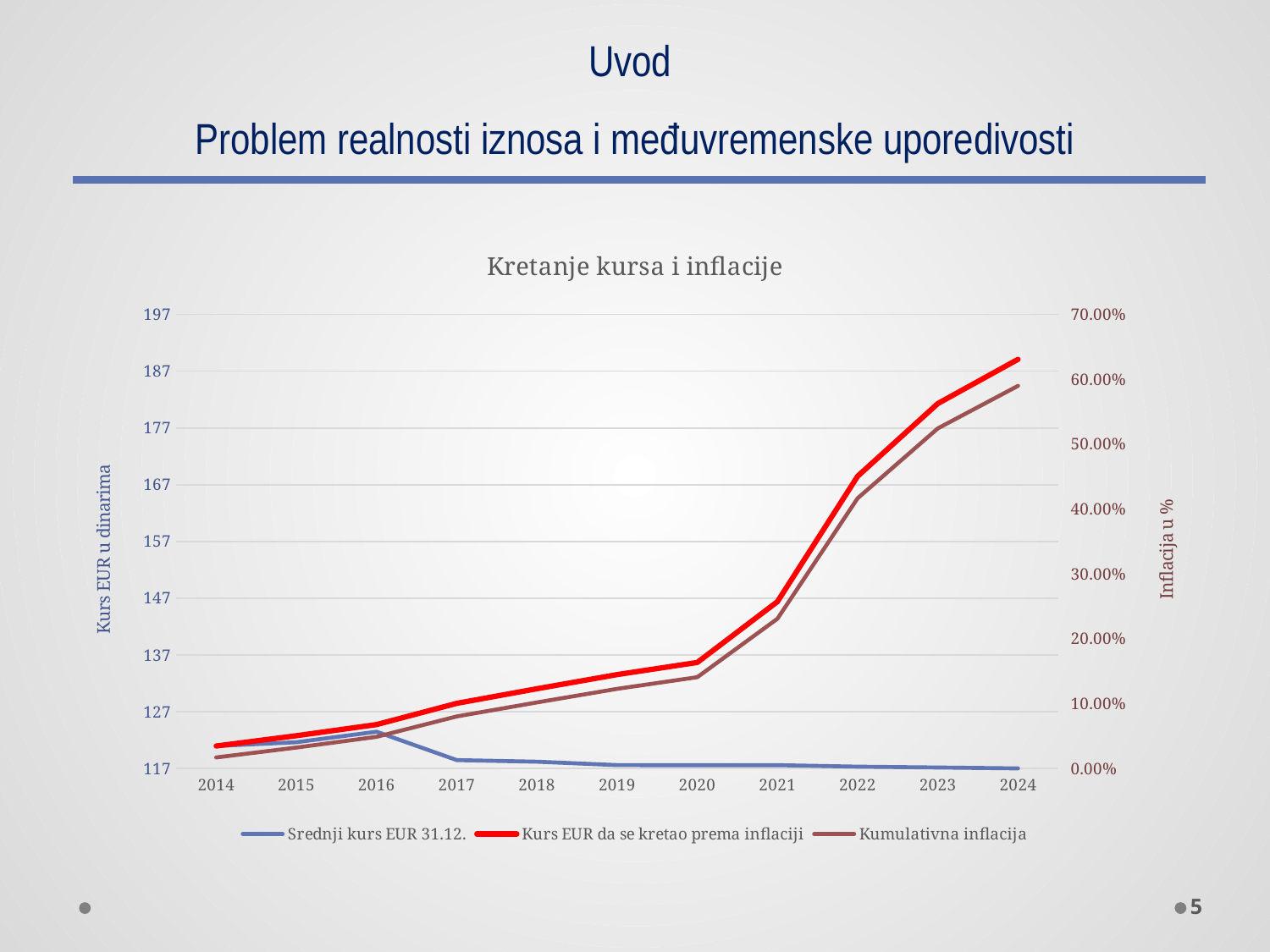
Is the value for 'Kumulativna inflacija' in 2024 greater or less than 50.00%? greater Is the value for 'Srednji kurs EUR 31.12.' in 2024 greater or less than 127? less In which year is the 'Kurs EUR da se kretao prema inflaciji' series highest? 2024 What is the label of the right-hand vertical axis? Inflacija u % In 2024, which is larger: 'Srednji kurs EUR 31.12.' or 'Kurs EUR da se kretao prema inflaciji'? Kurs EUR da se kretao prema inflaciji How many years are shown on the x axis? 11 What is the title of the chart? Kretanje kursa i inflacije In which year is the 'Kurs EUR da se kretao prema inflaciji' series lowest? 2014 Is the value for 'Kurs EUR da se kretao prema inflaciji' in 2024 greater or less than 177? greater What kind of chart is shown on the slide? line chart How many series does the legend list? 3 Does the 'Kumulativna inflacija' series rise or fall from 2014 to 2024? rise